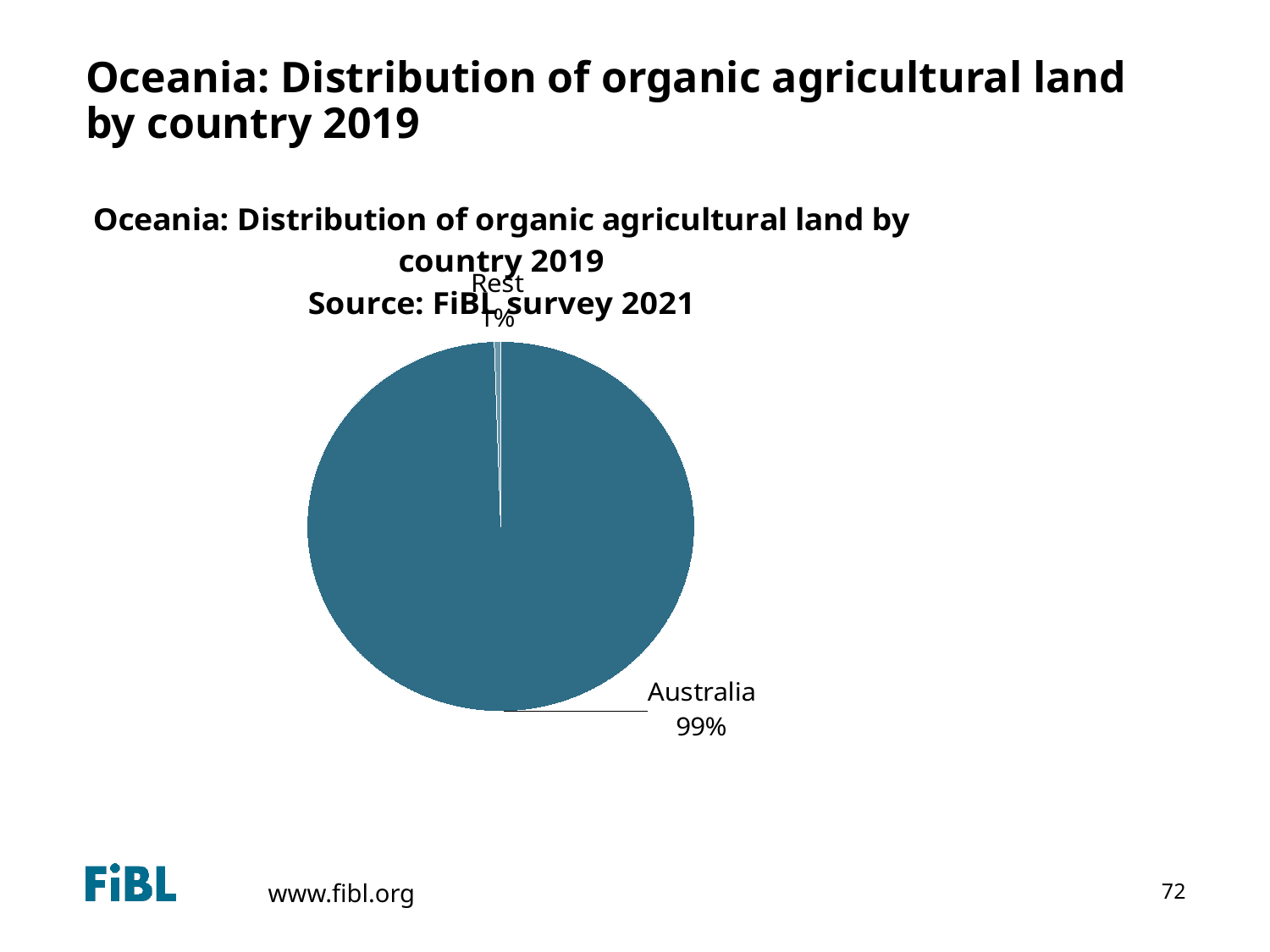
What share of organic agricultural land in Oceania does Australia hold? 99% Which is larger, the share for Australia or the share for Rest? Australia How many slices does the pie chart have? 2 What kind of chart is shown on the slide? pie chart Which slice of the pie is the smallest? Rest Which slice of the pie is the largest? Australia What is the title of the chart? Oceania: Distribution of organic agricultural land by country 2019 What source is cited for the chart data? FiBL survey 2021 What share of organic agricultural land in Oceania is labelled 'Rest'? 1% What is the difference in percentage points between Australia's share and the Rest's share? 98 percentage points